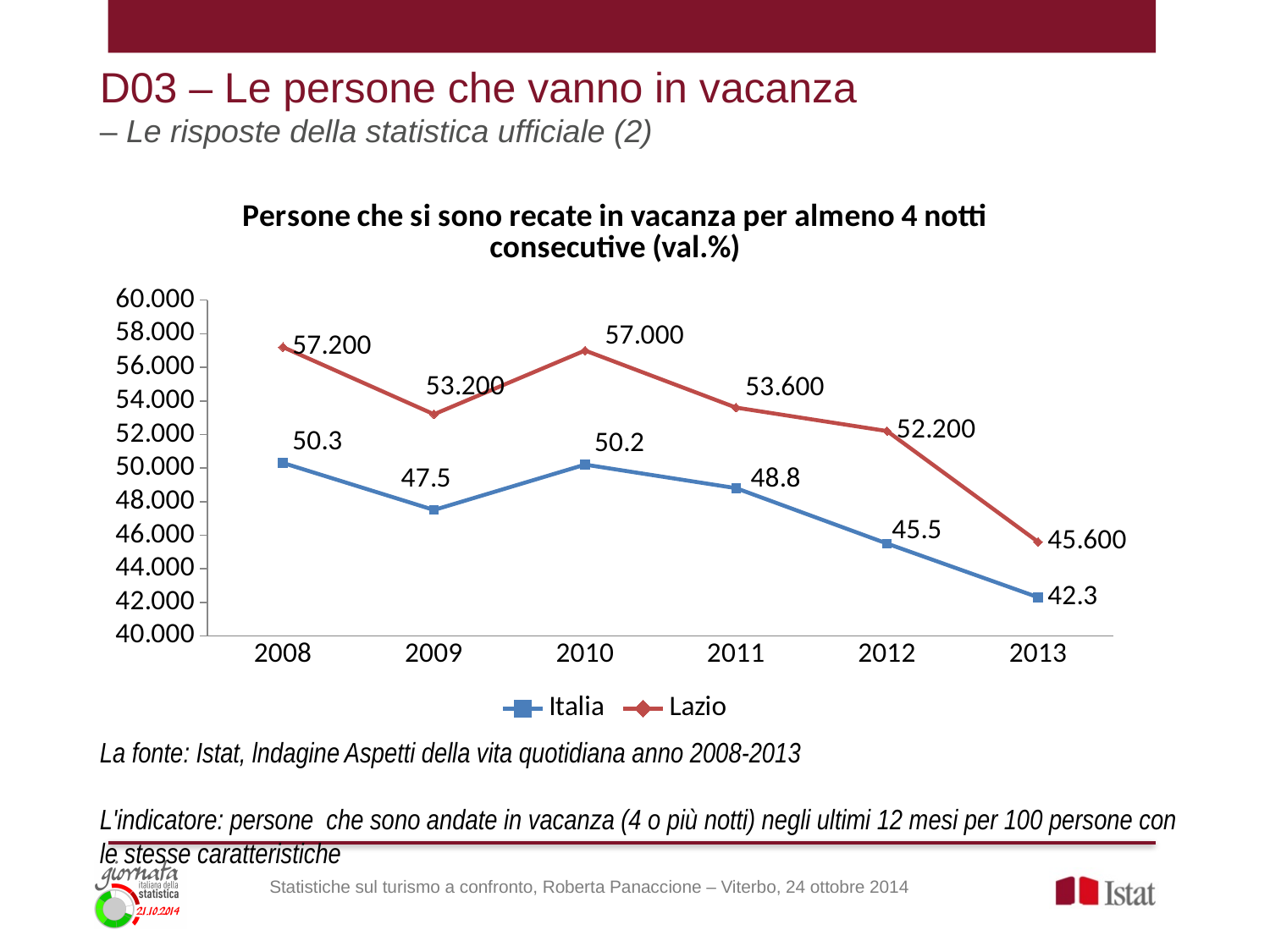
What is the value for Lazio in 2010? 57.000 What is the value for Lazio in 2012? 52.200 Overall, do the Italia values rise or fall from 2008 to 2013? fall In which year is the Italia series at its highest? 2008 Which series has the larger value in 2011, Italia or Lazio? Lazio What is the difference between the Italia values for 2008 and 2009? 2.8 What type of chart is shown on the slide? line chart What is the value for Italia in 2008? 50.3 How many years are shown on the x axis? 6 How many series does the legend list? 2 What is the value for Italia in 2013? 42.3 In which year is the Lazio series at its lowest? 2013